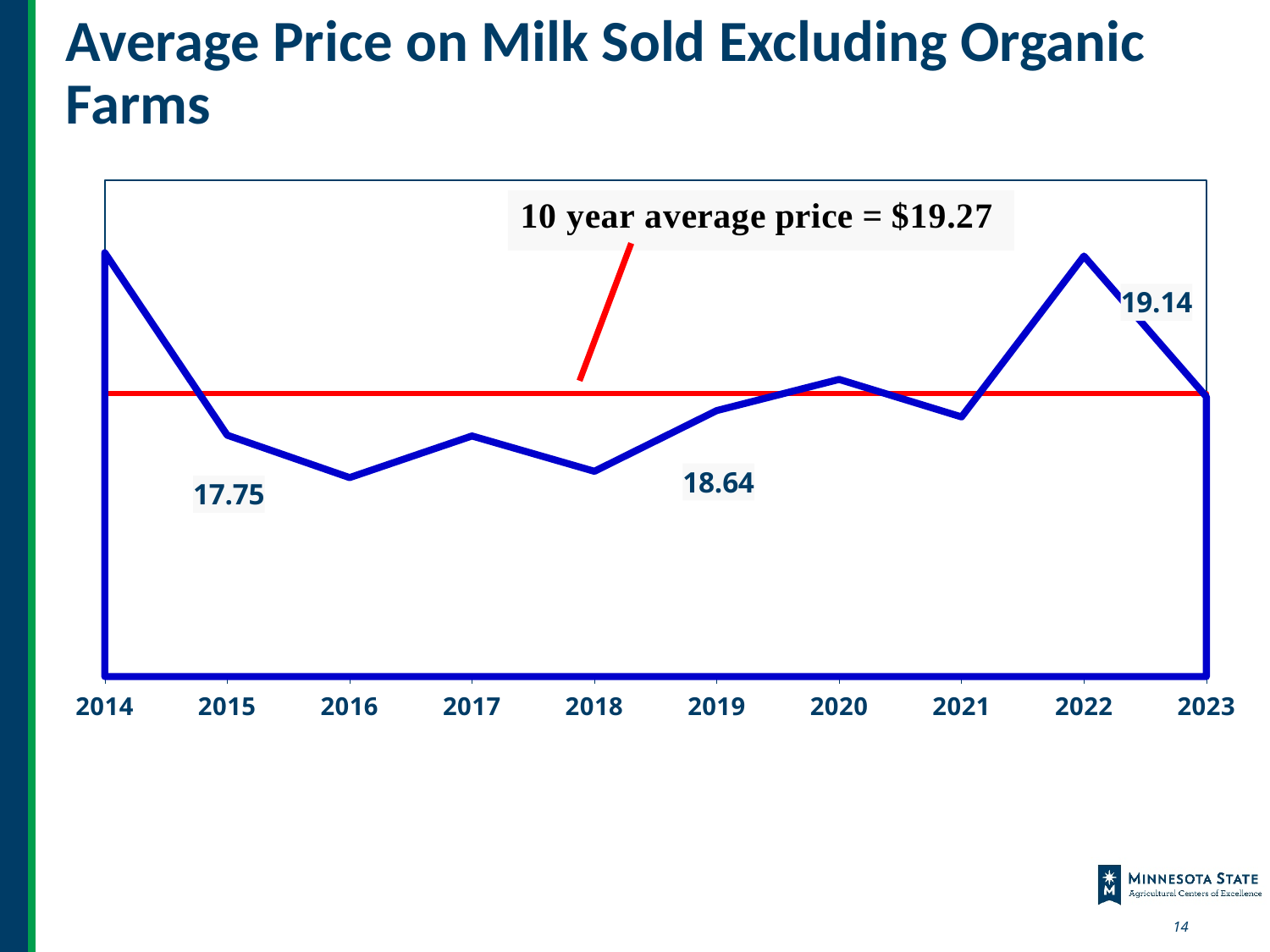
What value is labelled for 2019? 18.64 What value is labelled for 2015? 17.75 Is the value for 2016 above or below the 10 year average line? below Does the price rise or fall from 2014 to 2016? fall What is the 10 year average price shown on the chart? $19.27 How many years are plotted along the x axis? 10 Which is larger, the value for 2014 or the value for 2016? 2014 Is the value for 2022 above or below the 10 year average line? above Does the price rise or fall from 2021 to 2022? rise What is the difference between the labelled values for 2019 and 2015? 0.89 What kind of chart is shown on the slide? line chart